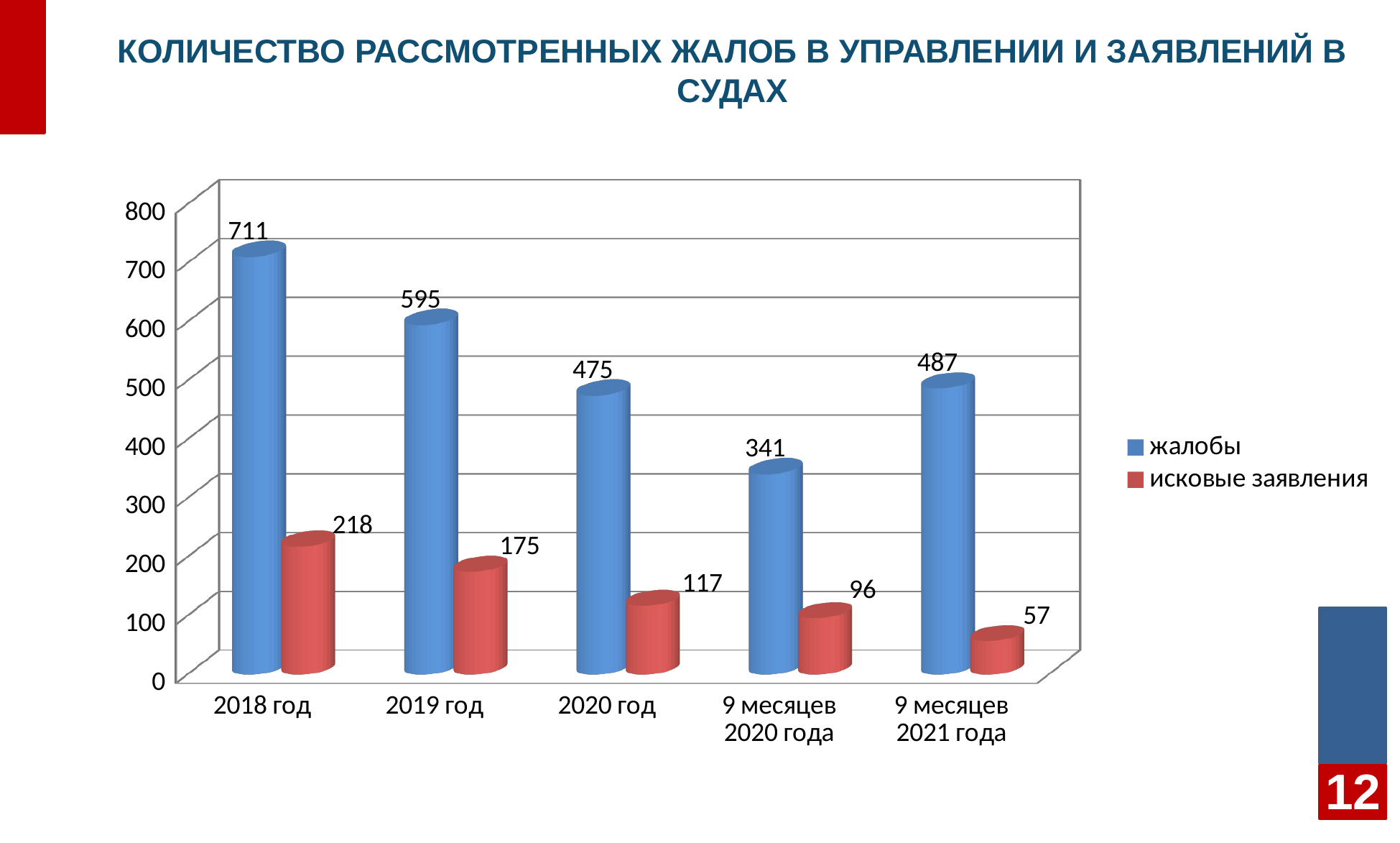
What is the value of жалобы for 9 месяцев 2020 года? 341 Which category has the highest value for жалобы? 2018 год How many categories are shown on the x axis? 5 What is the value of жалобы for 2018 год? 711 What is the value of исковые заявления for 9 месяцев 2021 года? 57 What kind of chart is shown on the slide? bar chart Is the value of исковые заявления for 2019 год greater or less than 200? less Which is larger: жалобы for 2020 год or жалобы for 9 месяцев 2021 года? 2020 год How many series does the legend list? 2 Do the values of исковые заявления rise or fall from 2018 год to 9 месяцев 2021 года? fall Which category has the lowest value for исковые заявления? 9 месяцев 2021 года What is the difference between жалобы in 2018 год and 2019 год? 116